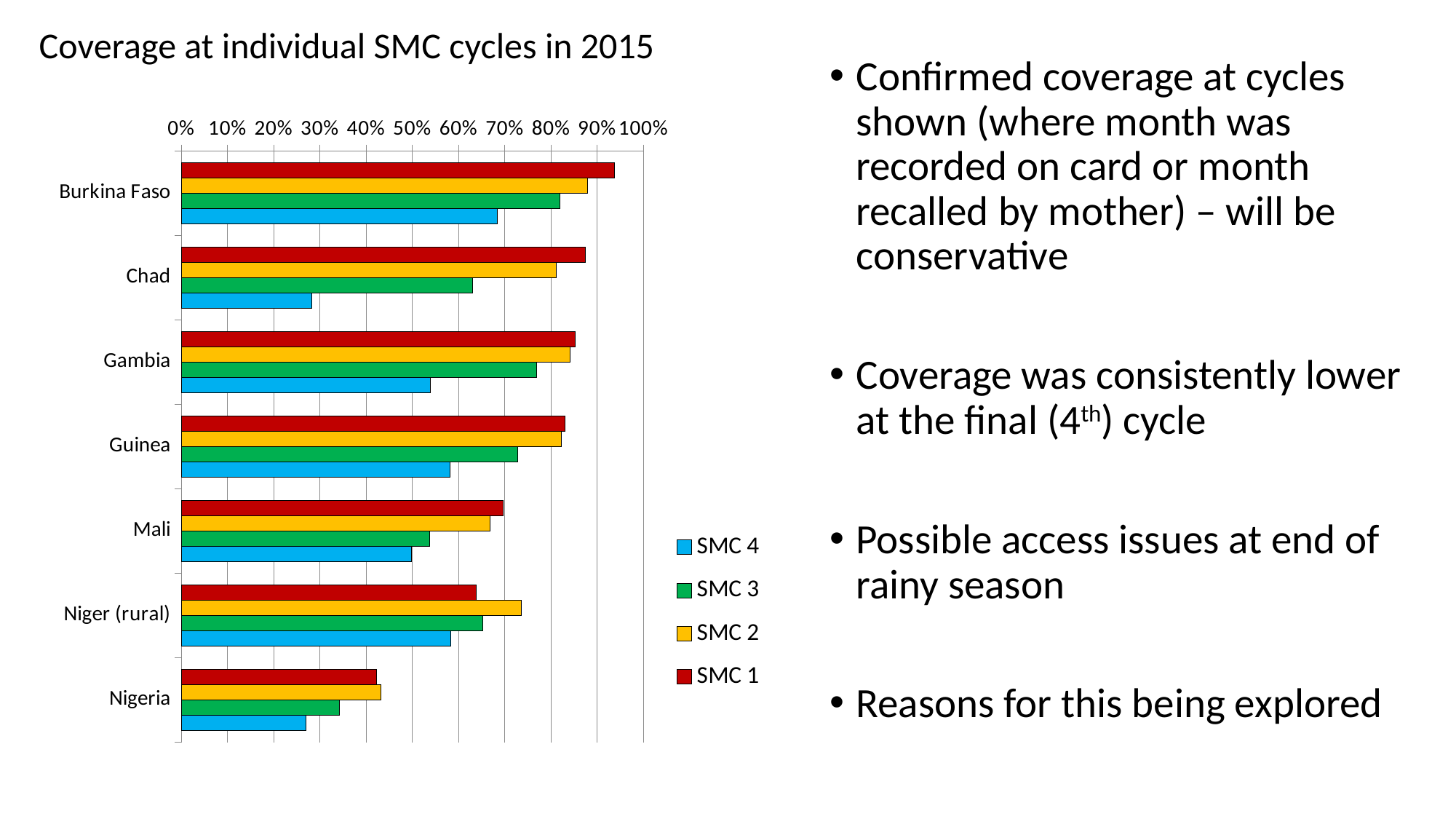
Which country has the highest SMC 1 coverage? Burkina Faso Is the SMC 1 coverage for Burkina Faso greater or less than 90%? greater How many countries are listed on the chart's vertical axis? 7 Which country has the lowest SMC 1 coverage? Nigeria What is the title of the chart? Coverage at individual SMC cycles in 2015 Is the SMC 4 coverage for Chad greater or less than 40%? less Is the SMC 1 coverage for Nigeria greater or less than 50%? less What kind of chart is shown on the slide? Bar chart Which colour represents SMC 4 in the legend? Blue How many series does the chart legend list? 4 Which country has the highest SMC 4 coverage? Burkina Faso For Niger (rural), which is larger: SMC 2 coverage or SMC 1 coverage? SMC 2